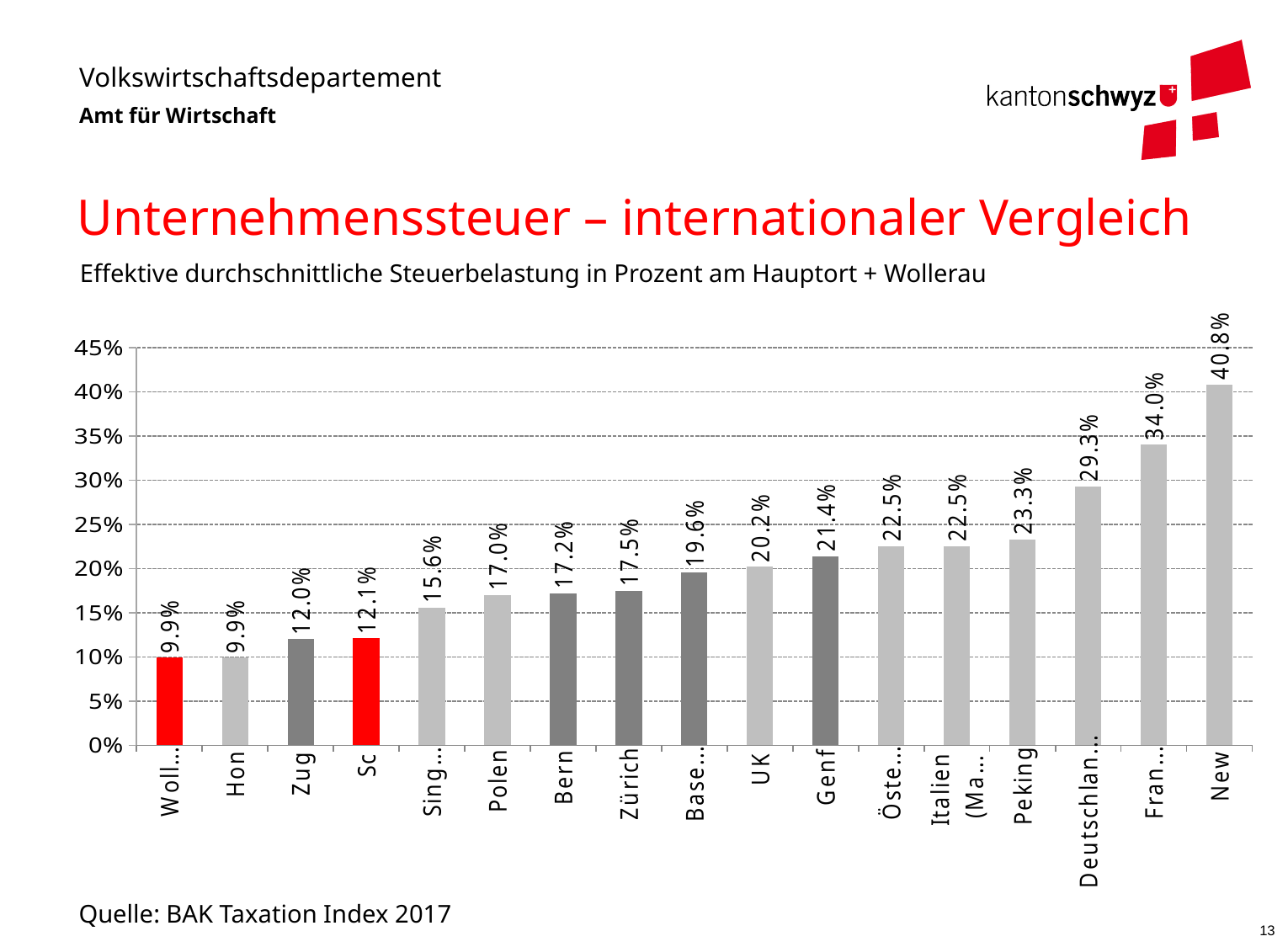
What is the value for UK? 20.2% What is the value for Zürich? 17.5% What is the value for Zug? 12.0% What is the value for Genf? 21.4% Which has a higher value, Bern or Polen? Bern What is the difference between the values for Genf and Zürich? 3.9 percentage points What is the value for Polen? 17.0% What kind of chart is shown on the slide? Bar chart What is the value for Peking? 23.3% Do the values rise or fall from left to right along the x axis? Rise What is the highest value shown in the chart? 40.8% How many bars are shown in the chart? 17